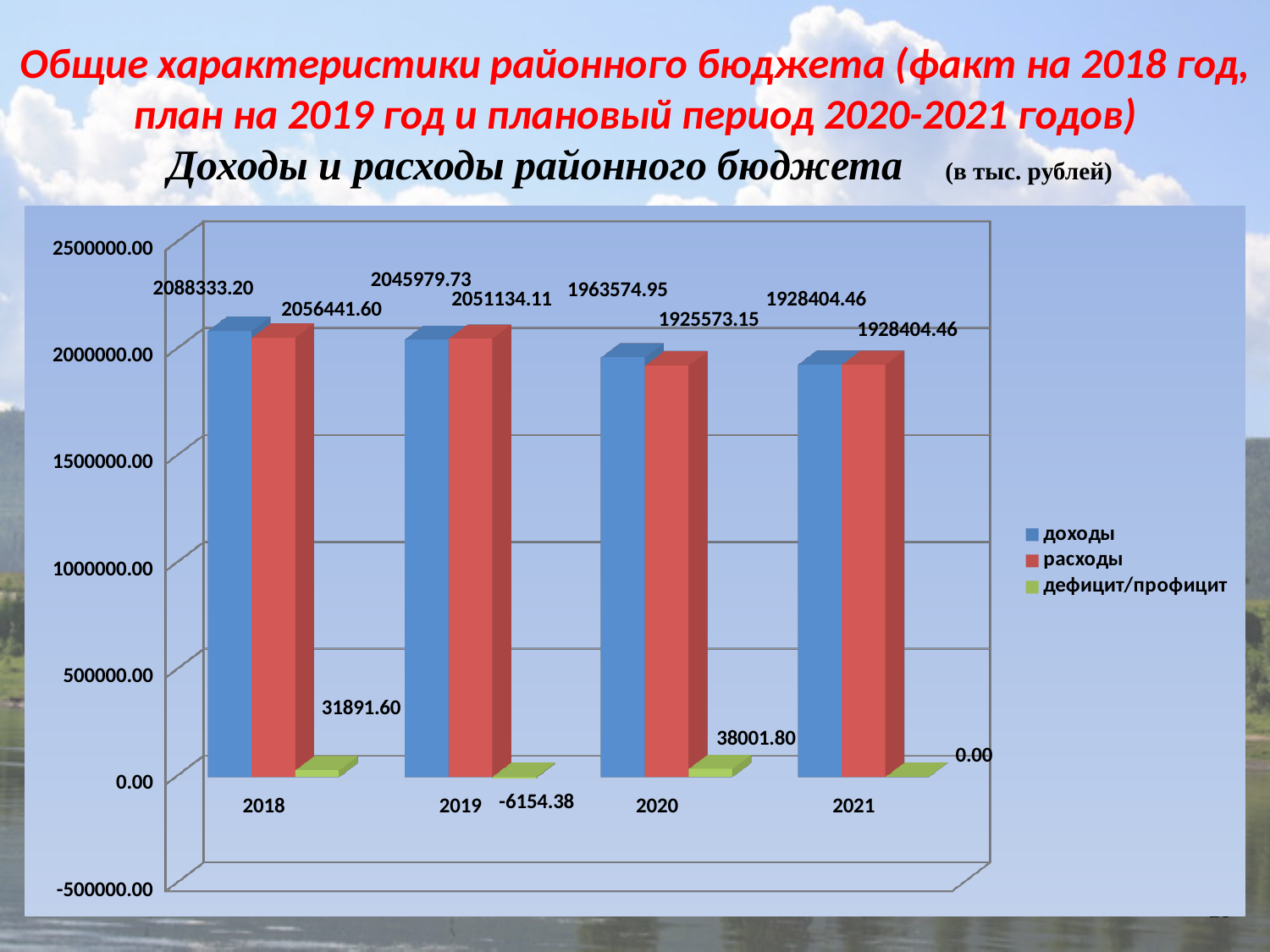
How many years are shown on the x axis? 4 What is the value of расходы for 2021? 1928404.46 In which year is доходы the lowest? 2021 What is the difference between доходы and расходы in 2018? 31891.60 What is the value of доходы for 2018? 2088333.20 Which is larger in 2019, доходы or расходы? расходы What is the value of дефицит/профицит for 2019? -6154.38 What is the value of дефицит/профицит for 2020? 38001.80 What is the value of расходы for 2019? 2051134.11 What kind of chart is shown on the slide? bar chart How many series does the legend list? 3 In which year is доходы the highest? 2018